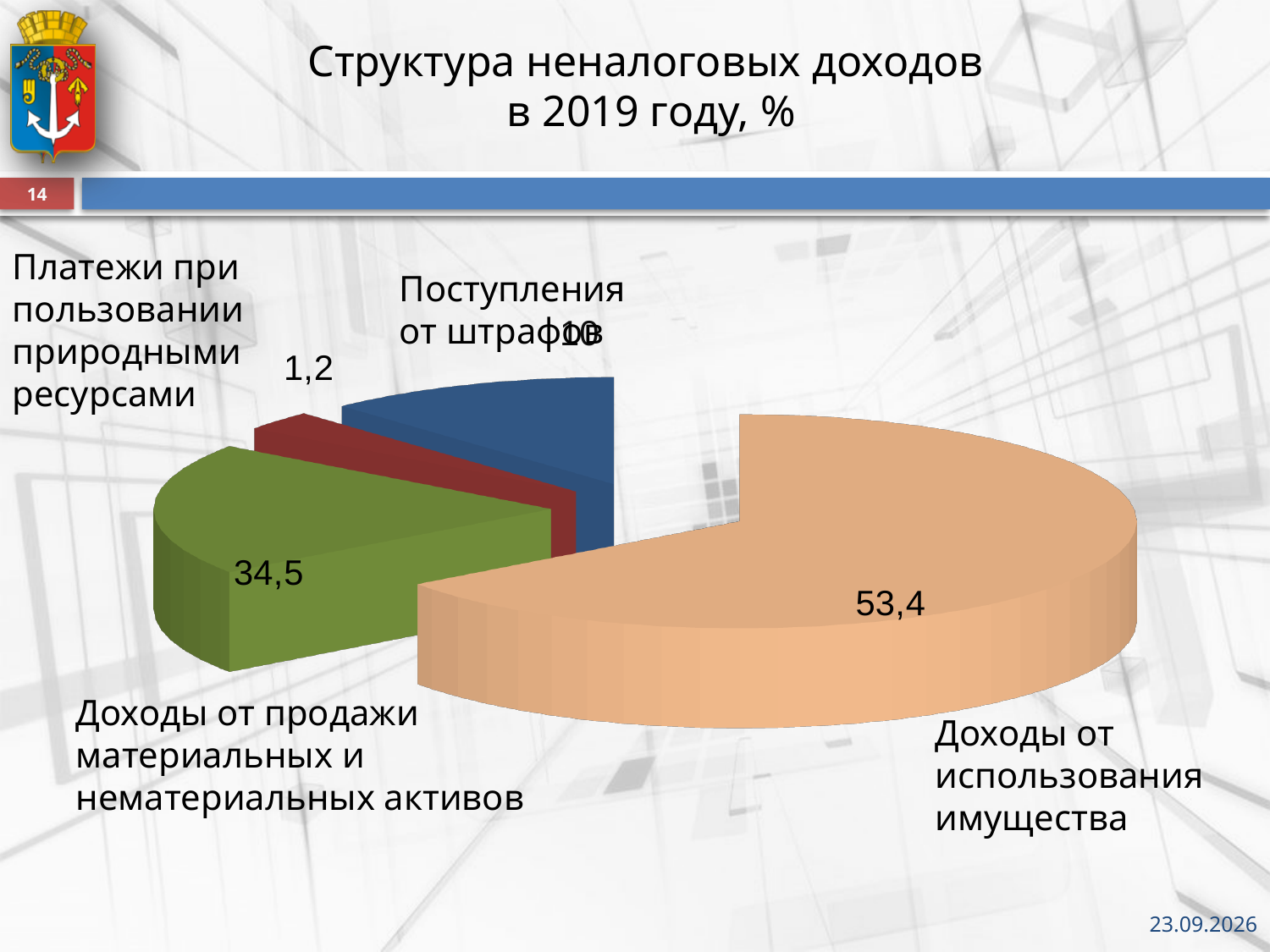
What is the value for Платежи при пользовании природными ресурсами? 1,2 What is the value for Доходы от продажи материальных и нематериальных активов? 34,5 What is the value for Доходы от использования имущества? 53,4 What kind of chart is shown on the slide? Pie chart How many slices does the pie chart have? 4 Which is larger: Доходы от продажи материальных и нематериальных активов or Платежи при пользовании природными ресурсами? Доходы от продажи материальных и нематериальных активов Which category has the smallest share of the pie? Платежи при пользовании природными ресурсами Which category has the largest share of the pie? Доходы от использования имущества What is the difference between the values for Доходы от использования имущества and Доходы от продажи материальных и нематериальных активов? 18,9 What is the title of the chart? Структура неналоговых доходов в 2019 году, % What colour is the slice for Доходы от продажи материальных и нематериальных активов? Green What is the difference between the values for Доходы от продажи материальных и нематериальных активов and Платежи при пользовании природными ресурсами? 33,3